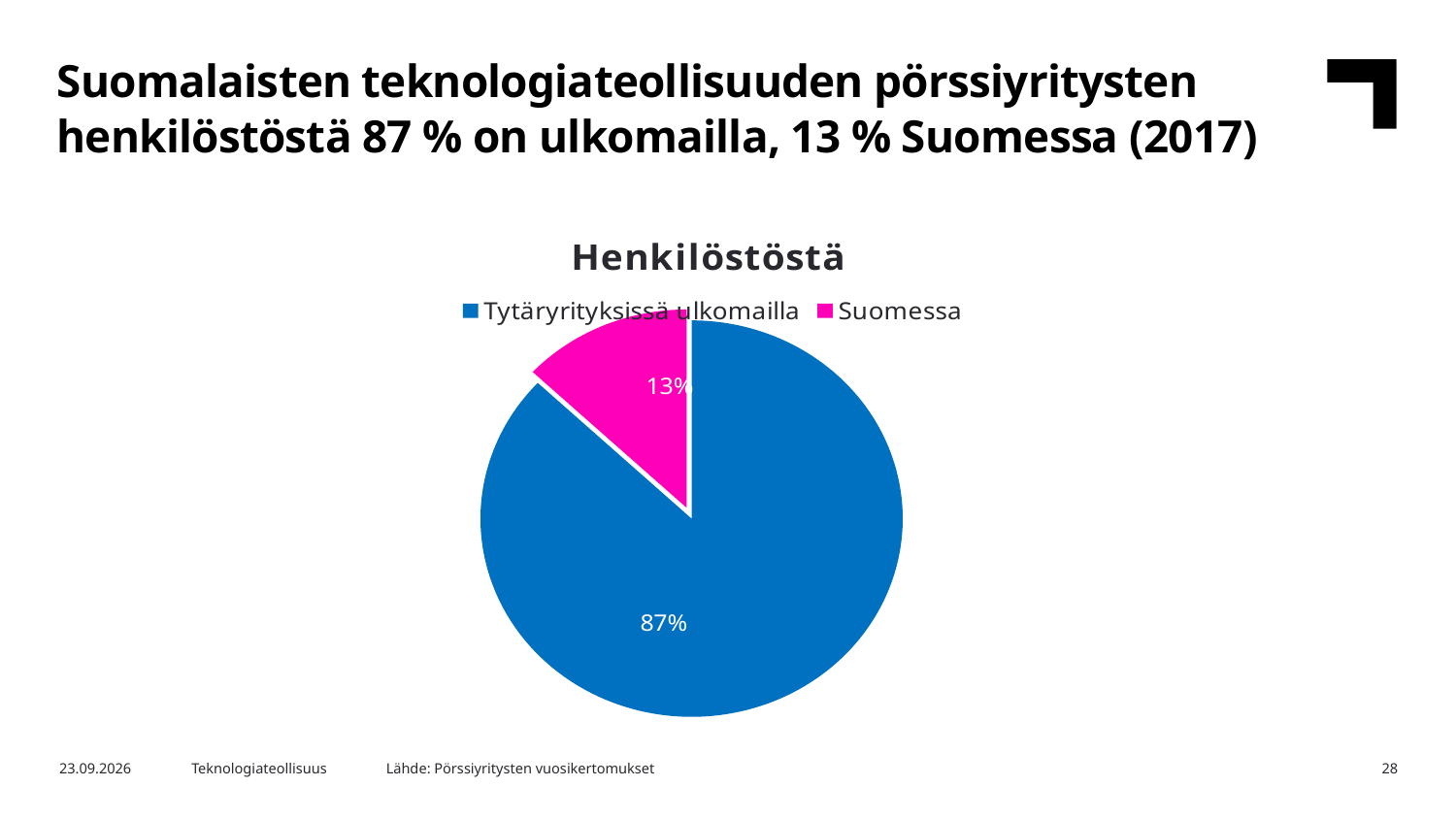
What colour is the "Suomessa" slice? Magenta (pink) Which is larger, the share for "Suomessa" or the share for "Tytäryrityksissä ulkomailla"? Tytäryrityksissä ulkomailla Which slice of the pie is the largest? Tytäryrityksissä ulkomailla What is the title of the chart? Henkilöstöstä What share of the pie does "Suomessa" represent? 13% What kind of chart is shown on the slide? Pie chart What share of the pie does "Tytäryrityksissä ulkomailla" represent? 87% Which slice of the pie is the smallest? Suomessa How many slices does the pie chart have? 2 What is the difference in percentage points between the "Tytäryrityksissä ulkomailla" slice and the "Suomessa" slice? 74 percentage points What is the total of the two slices shown in the pie chart? 100% How many entries does the legend list? 2